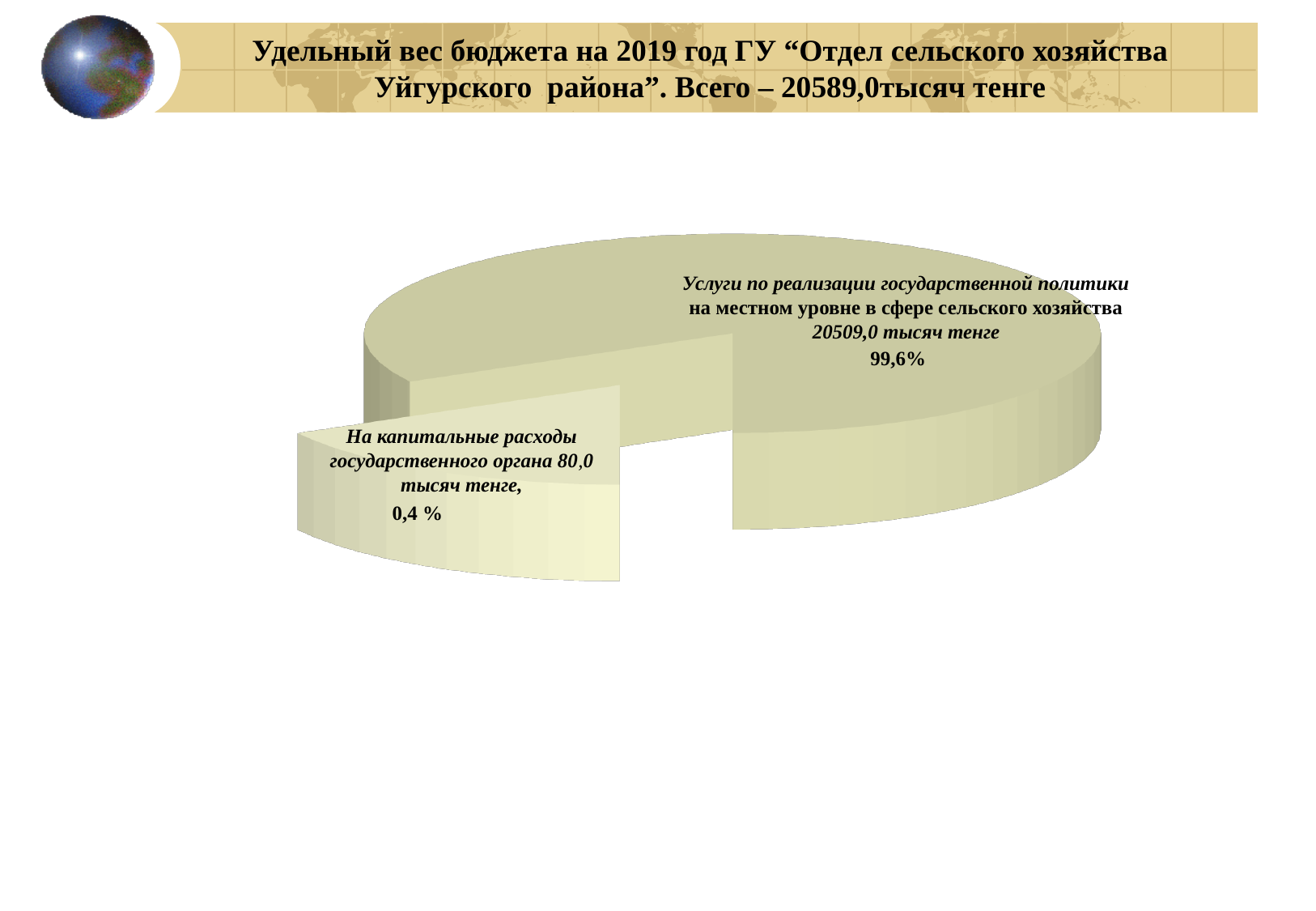
Which slice is the largest in the pie chart? Услуги по реализации государственной политики на местном уровне в сфере сельского хозяйства What kind of chart is shown on the slide? pie chart What is the difference between the value for "Услуги по реализации государственной политики на местном уровне в сфере сельского хозяйства" and the value for "На капитальные расходы государственного органа"? 20429,0 тысяч тенге What total budget amount is stated in the slide title? 20589,0 тысяч тенге Which is larger: the value for "Услуги по реализации государственной политики" or the value for "На капитальные расходы государственного органа"? Услуги по реализации государственной политики How many slices does the pie chart have? 2 What share of the pie does "На капитальные расходы государственного органа" represent? 0,4 % Which slice is the smallest in the pie chart? На капитальные расходы государственного органа What is the value for "Услуги по реализации государственной политики на местном уровне в сфере сельского хозяйства"? 20509,0 тысяч тенге What is the value for "На капитальные расходы государственного органа"? 80,0 тысяч тенге What share of the pie does "Услуги по реализации государственной политики на местном уровне в сфере сельского хозяйства" represent? 99,6% For which year is the budget shown in the chart? 2019